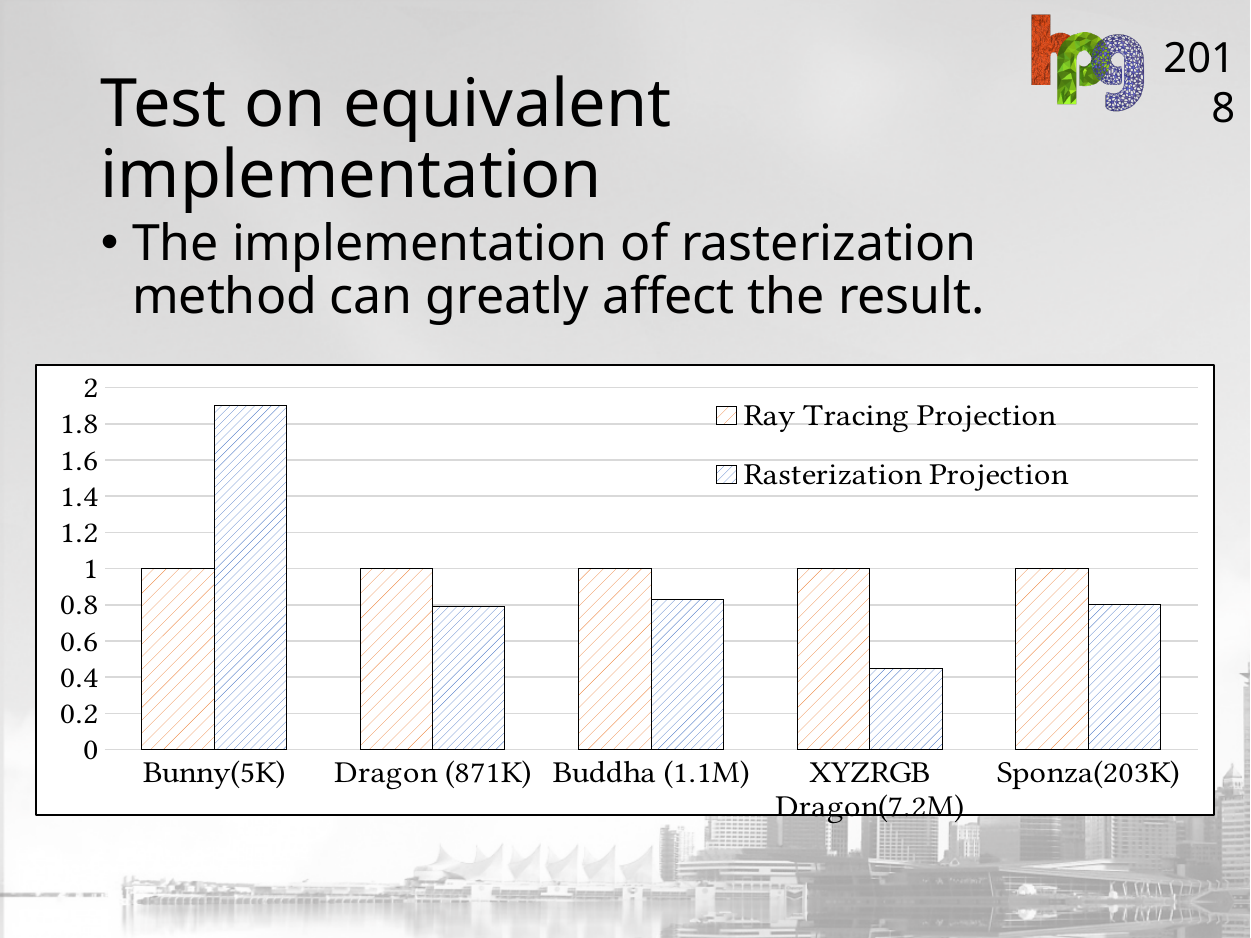
What is the Ray Tracing Projection value for Bunny(5K)? 1 What kind of chart is shown on the slide? bar chart Is the Rasterization Projection value for Bunny(5K) greater or less than 1.6? greater What are the two series named in the chart's legend? Ray Tracing Projection and Rasterization Projection How many categories are shown along the x axis of the chart? 5 Which category has the lowest Rasterization Projection value? XYZRGB Dragon(7.2M) Is the Rasterization Projection value for Sponza(203K) greater or less than 1? less How many series does the chart's legend list? 2 What is the Ray Tracing Projection value for Sponza(203K)? 1 For Dragon (871K), which series has the larger value, Ray Tracing Projection or Rasterization Projection? Ray Tracing Projection Which category has the highest Rasterization Projection value? Bunny(5K) Is the Rasterization Projection value for XYZRGB Dragon(7.2M) greater or less than 0.6? less